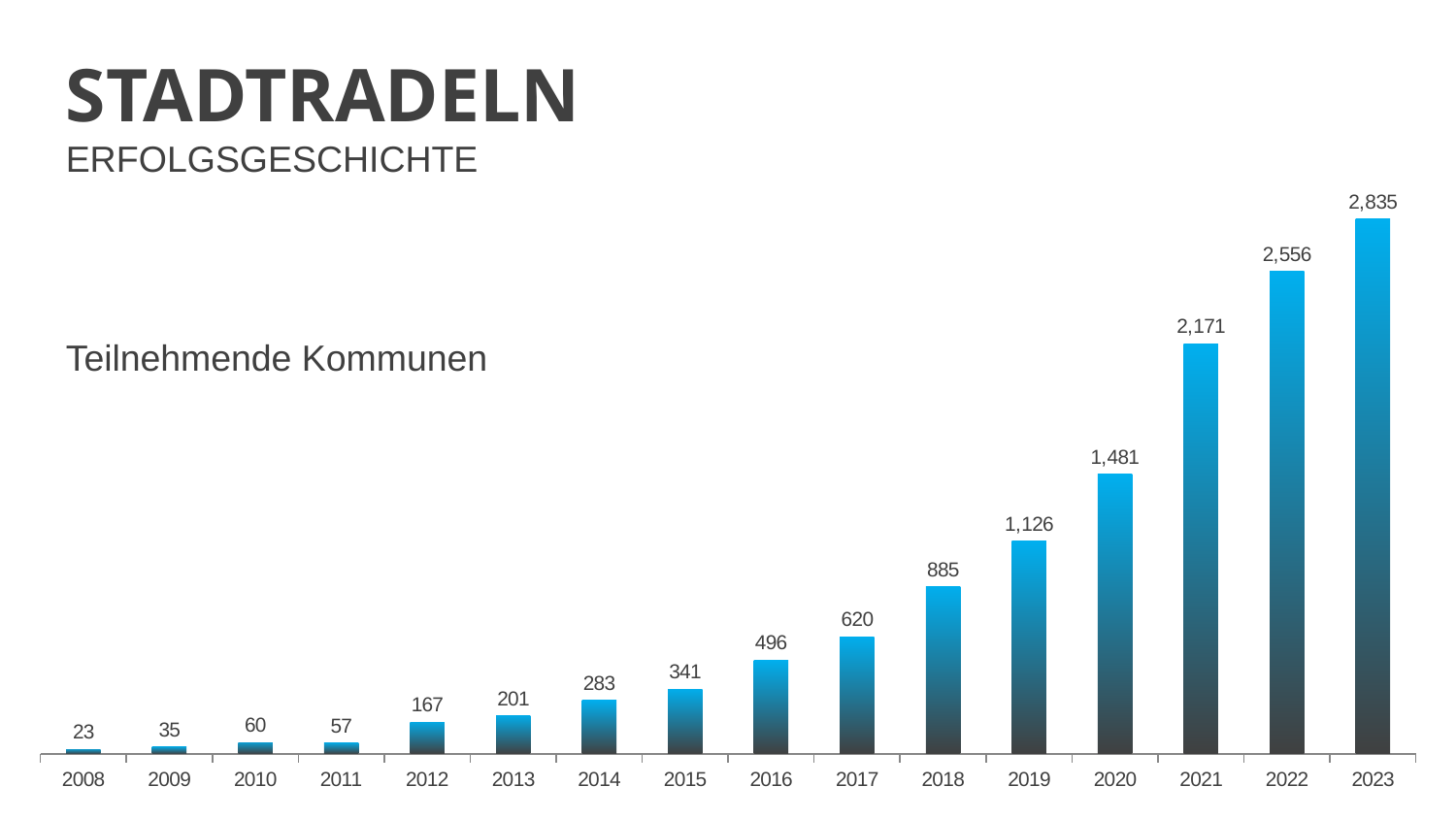
What kind of chart is this? bar chart What is the difference between the values for 2023 and 2022? 279 Which year has the highest value? 2023 What is the difference between the values for 2020 and 2019? 355 Which is larger, the value for 2010 or the value for 2011? 2010 What is the value for 2012? 167 What is the value for 2019? 1,126 What does the chart show, according to the label on the slide? Teilnehmende Kommunen What is the value for 2023? 2,835 How many years are shown on the x axis? 16 Do the values generally rise or fall from 2008 to 2023? rise Which year has the lowest value? 2008